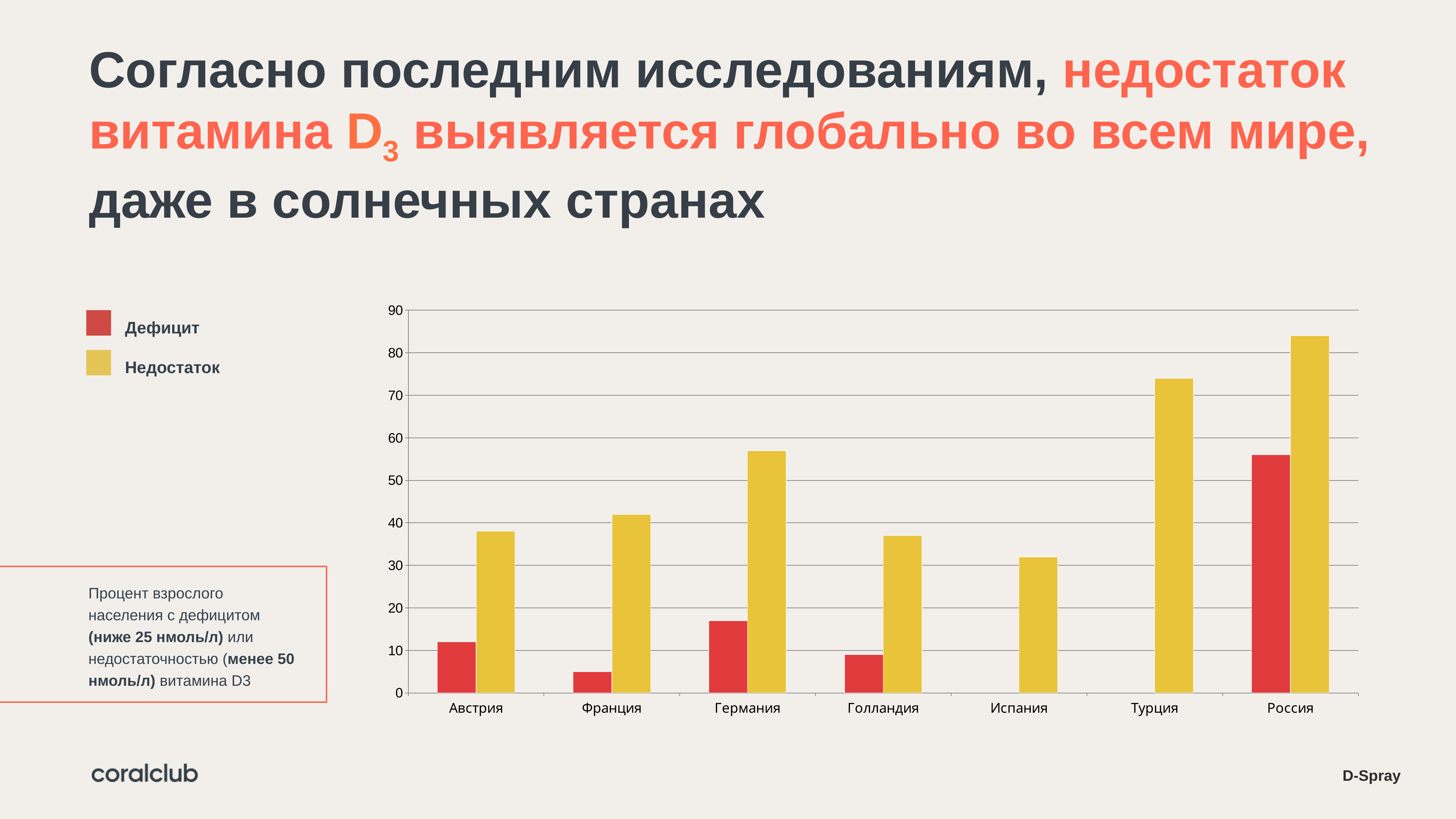
Is the Недостаток value for Турция greater or less than 70? greater Which country has the lowest Недостаток value? Испания Which country has the highest Недостаток value? Россия Which is larger: the Недостаток value for Германия or for Франция? Германия Which country has the highest Дефицит value? Россия Is the Недостаток value for Германия greater or less than 60? less Is the Дефицит value for Франция greater or less than 10? less What kind of chart is shown on the slide? bar chart How many series does the chart's legend list? 2 How many countries are shown on the x axis of the chart? 7 What colour are the Дефицит bars in the chart? red